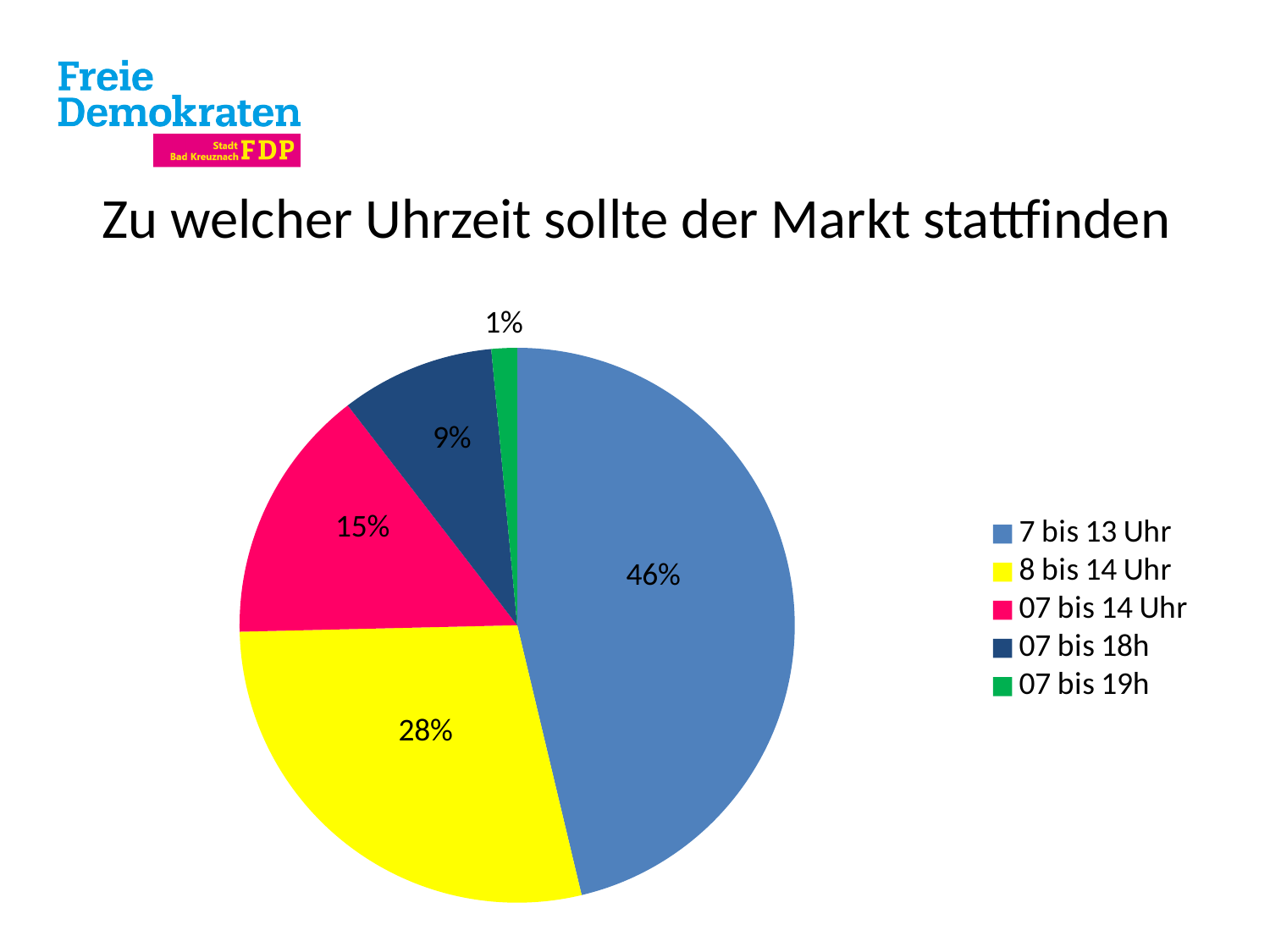
How many categories does the legend list? 5 Which time slot has the smallest share of the pie? 07 bis 19h Which has a larger share, "07 bis 14 Uhr" or "07 bis 18h"? 07 bis 14 Uhr What kind of chart is shown on the slide? pie chart What share of the pie does "8 bis 14 Uhr" have? 28% What share of the pie does "7 bis 13 Uhr" have? 46% What share of the pie does "07 bis 18h" have? 9% What is the difference in percentage points between "7 bis 13 Uhr" and "8 bis 14 Uhr"? 18 What is the title of the chart? Zu welcher Uhrzeit sollte der Markt stattfinden Which time slot has the largest share of the pie? 7 bis 13 Uhr